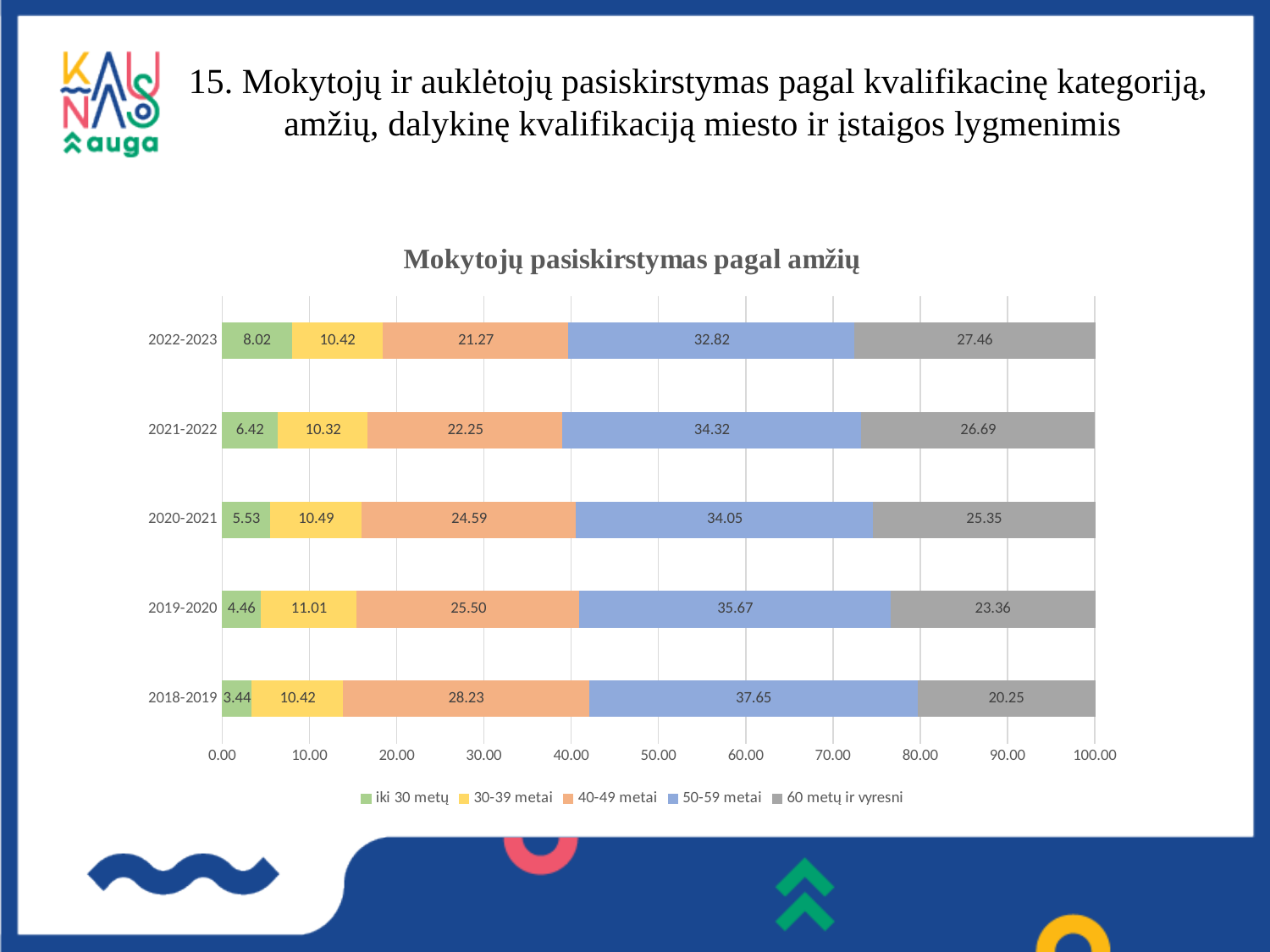
What is the value for '50-59 metai' in 2018-2019? 37.65 Which school year has the highest value for '60 metų ir vyresni'? 2022-2023 How many series does the legend list? 5 Which school year has the lowest value for 'iki 30 metų'? 2018-2019 Which is larger: the '40-49 metai' value in 2018-2019 or in 2022-2023? 2018-2019 What is the value for 'iki 30 metų' in 2022-2023? 8.02 What type of chart is shown on the slide? Stacked bar chart What is the title of the chart? Mokytojų pasiskirstymas pagal amžių How many school years (categories) are shown on the chart? 5 What is the value for '60 metų ir vyresni' in 2020-2021? 25.35 Does the 'iki 30 metų' value increase or decrease from 2018-2019 to 2022-2023? Increase What is the difference between the '50-59 metai' value in 2018-2019 and in 2022-2023? 4.83